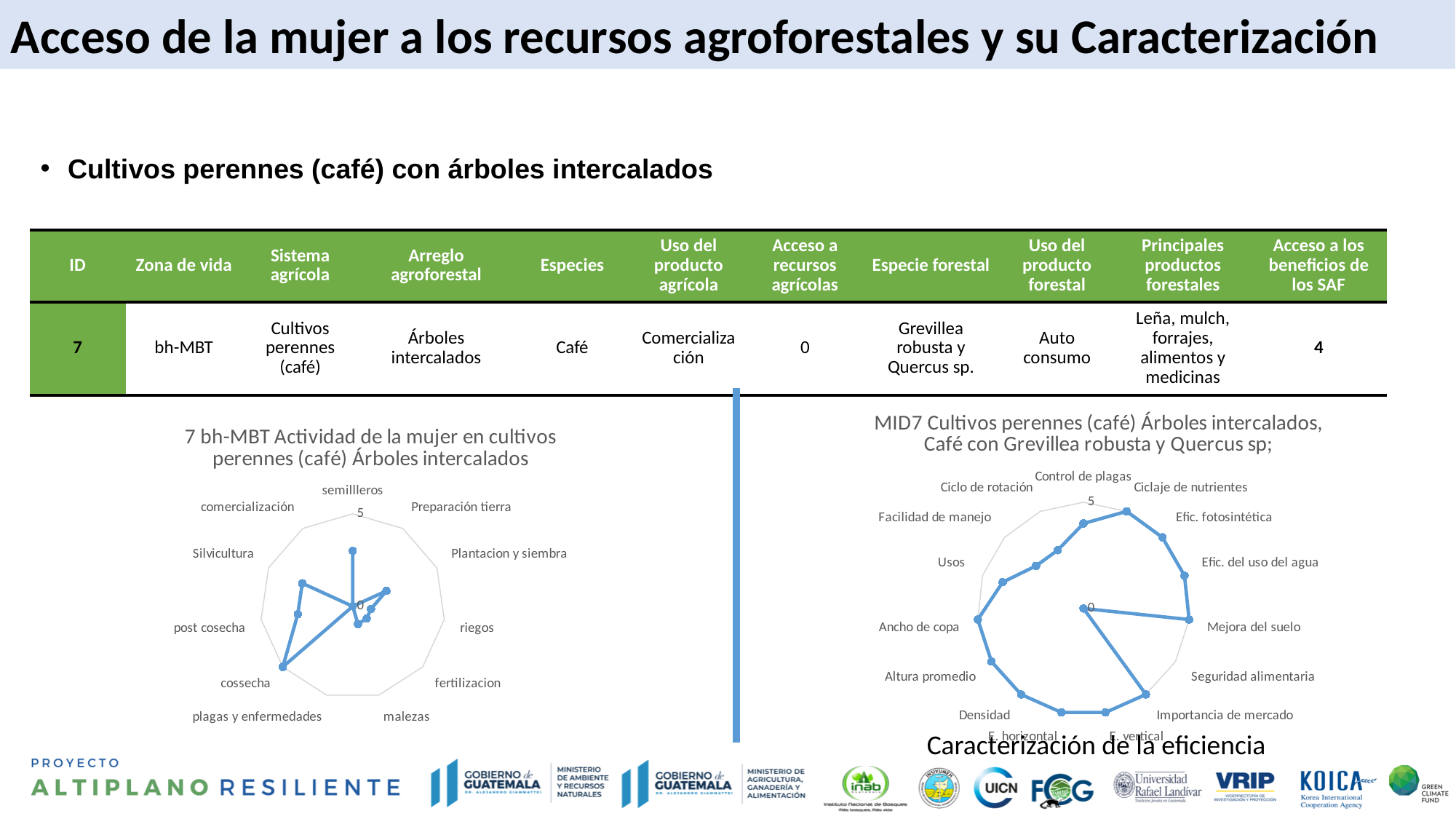
In the right chart (MID7 Cultivos perennes), which category has the lowest value? Seguridad alimentaria In the right chart (MID7 Cultivos perennes), how many categories are plotted around the radar? 15 In the right chart (MID7 Cultivos perennes), is the value for Mejora del suelo greater or less than 4? greater In the left chart (7 bh-MBT Actividad de la mujer), how many categories are plotted around the radar? 11 In the left chart (7 bh-MBT Actividad de la mujer), is the value for cossecha greater or less than 4? greater In the right chart (MID7 Cultivos perennes), is the value for Seguridad alimentaria greater or less than 2? less What kind of chart is the left chart titled '7 bh-MBT Actividad de la mujer en cultivos perennes (café) Árboles intercalados'? Radar chart In the right chart (MID7 Cultivos perennes), which is larger, the value for Mejora del suelo or the value for Seguridad alimentaria? Mejora del suelo In the left chart (7 bh-MBT Actividad de la mujer), which category has the highest value? cossecha What kind of chart is the right chart titled 'MID7 Cultivos perennes (café) Árboles intercalados, Café con Grevillea robusta y Quercus sp;'? Radar chart What is the maximum value shown on the radial axis of the left chart (7 bh-MBT Actividad de la mujer)? 5